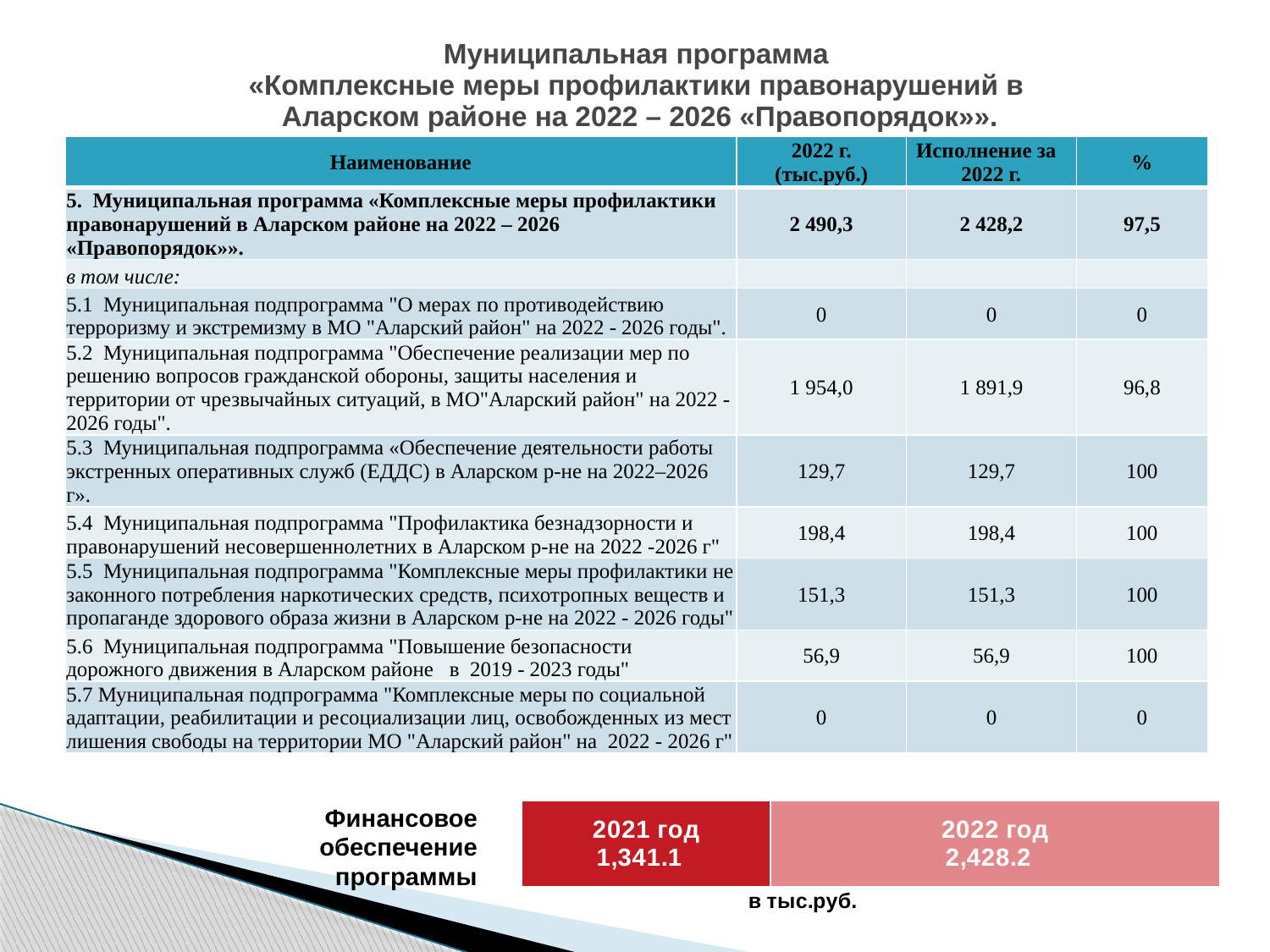
In the 'Финансовое обеспечение программы' chart at the bottom of the slide, what is the value for 2022 год? 2,428.2 In the 'Финансовое обеспечение программы' chart at the bottom of the slide, what is the value for 2021 год? 1,341.1 In the 'Финансовое обеспечение программы' chart, which year has the lowest value? 2021 год What kind of chart is the 'Финансовое обеспечение программы' chart at the bottom of the slide? bar chart What is the title of the chart at the bottom of the slide? Финансовое обеспечение программы How many years are shown in the 'Финансовое обеспечение программы' chart? 2 In the 'Финансовое обеспечение программы' chart, which year has the highest value? 2022 год In the 'Финансовое обеспечение программы' chart, do the values rise or fall from 2021 год to 2022 год? rise In the 'Финансовое обеспечение программы' chart, what is the difference between the 2022 год and 2021 год values? 1,087.1 In what units are the values of the 'Финансовое обеспечение программы' chart given? тыс.руб. In the 'Финансовое обеспечение программы' chart, which is larger: the value for 2021 год or for 2022 год? 2022 год